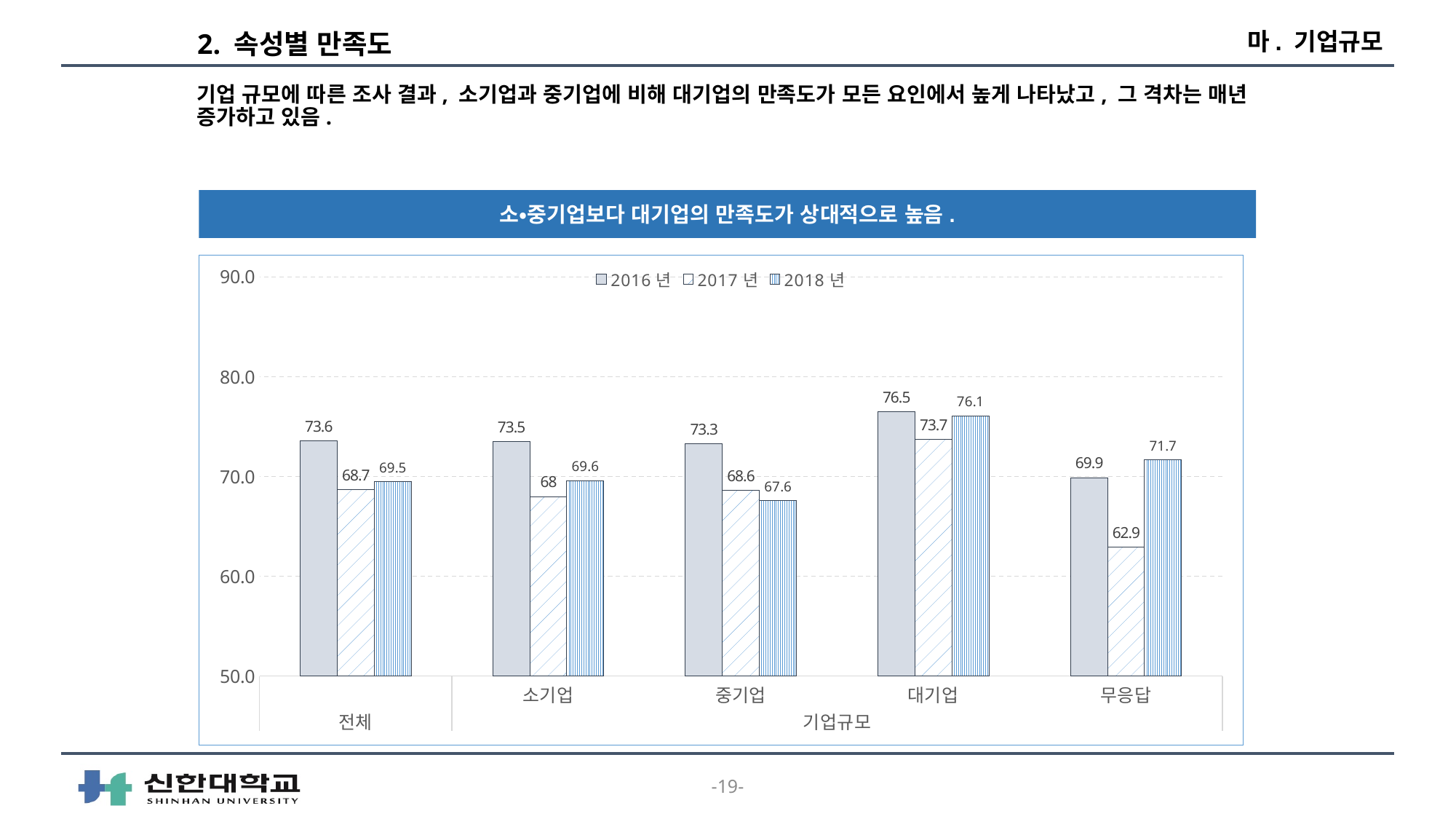
What is the value for 대기업 in the 2016 년 series? 76.5 What is the value for 소기업 in the 2018 년 series? 69.6 Is the 2017 년 value for 무응답 greater or less than 70.0? less How many series does the legend list? 3 How many categories are shown on the x axis? 5 Which category has the lowest value in the 2017 년 series? 무응답 What is the value for 무응답 in the 2017 년 series? 62.9 What is the difference between the 2016 년 and 2017 년 values for 중기업? 4.7 What kind of chart is shown on the slide? bar chart Which is larger for 무응답: the 2016 년 value or the 2018 년 value? 2018 년 Which category has the highest value in the 2018 년 series? 대기업 What is the value for 전체 in the 2016 년 series? 73.6